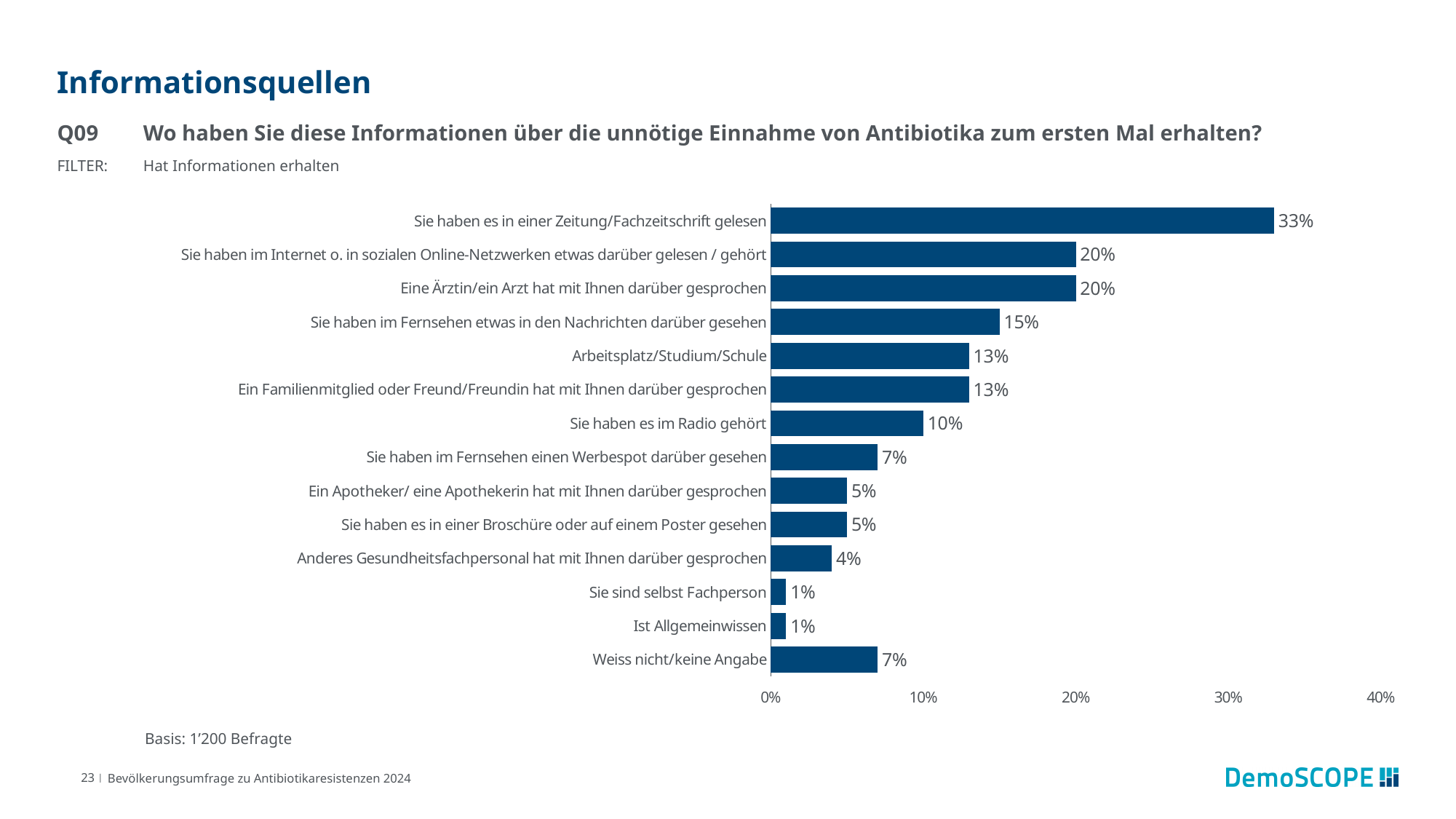
Which is larger: "Sie haben es im Radio gehört" or "Arbeitsplatz/Studium/Schule"? Arbeitsplatz/Studium/Schule What is the value for "Weiss nicht/keine Angabe"? 7% Which category has the highest value? Sie haben es in einer Zeitung/Fachzeitschrift gelesen What is the value for "Sie haben es in einer Zeitung/Fachzeitschrift gelesen"? 33% How many categories are shown in the chart? 14 What is the basis (number of respondents) stated below the chart? 1'200 Befragte What is the value for "Anderes Gesundheitsfachpersonal hat mit Ihnen darüber gesprochen"? 4% What kind of chart is shown on the slide? Bar chart What is the difference between "Sie haben im Fernsehen etwas in den Nachrichten darüber gesehen" and "Sie haben im Fernsehen einen Werbespot darüber gesehen"? 8% Is the value for "Sie haben es in einer Zeitung/Fachzeitschrift gelesen" greater or less than 30%? greater What is the difference between "Sie haben es in einer Zeitung/Fachzeitschrift gelesen" and "Eine Ärztin/ein Arzt hat mit Ihnen darüber gesprochen"? 13% What is the value for "Sie haben es im Radio gehört"? 10%